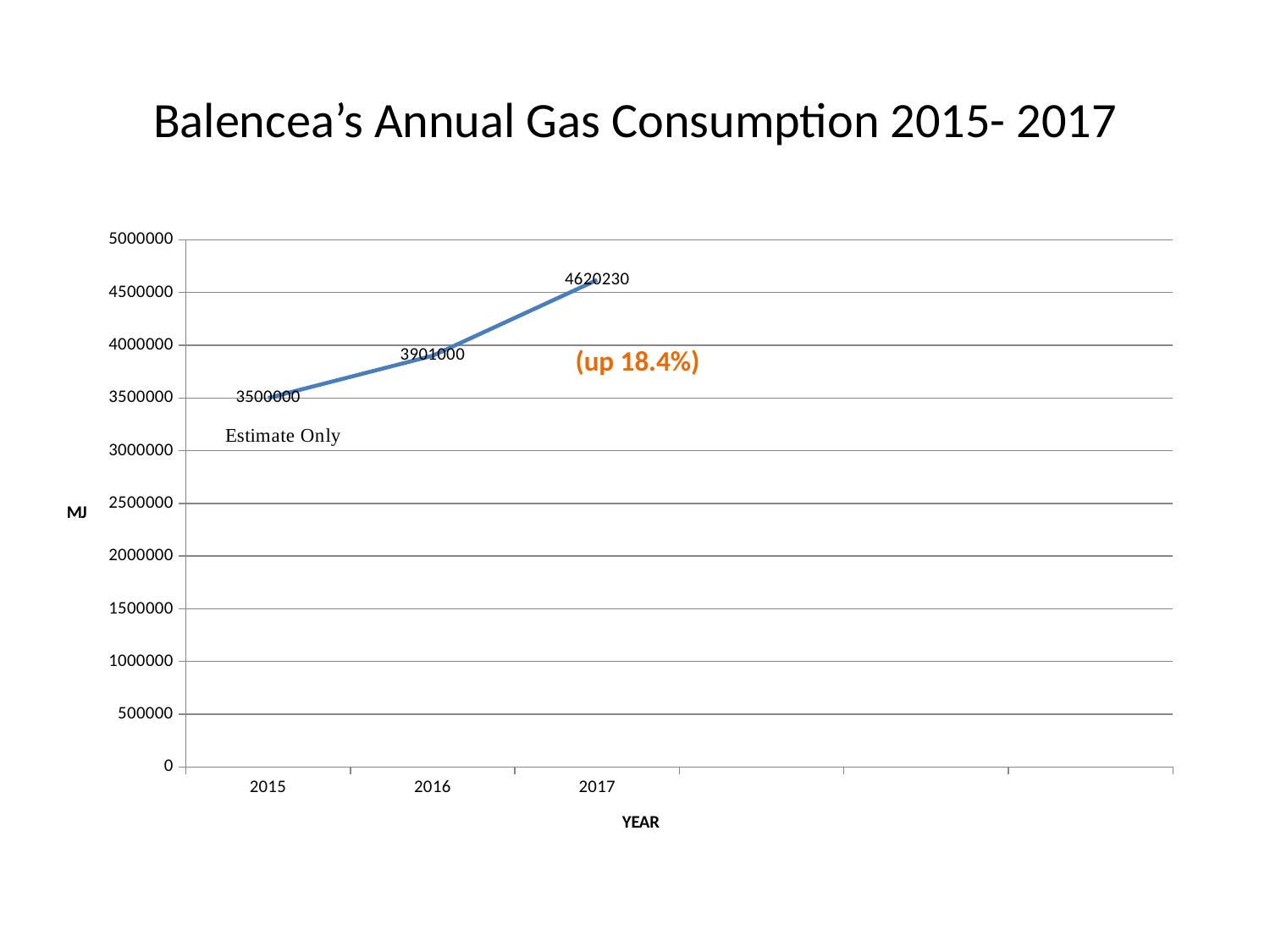
Is the value for 2017 greater or less than 4500000? greater Do the values rise or fall from 2015 to 2017? rise What is the difference between the 2017 and 2016 values? 719230 Which year has the highest gas consumption? 2017 What is the difference between the 2016 and 2015 values? 401000 Which year has the lowest gas consumption? 2015 What is the gas consumption value for 2016? 3901000 What is the gas consumption value for 2015? 3500000 How many years are plotted on the chart? 3 What is the gas consumption value for 2017? 4620230 Which is larger, the value for 2016 or the value for 2015? 2016 What kind of chart is shown on the slide? line chart